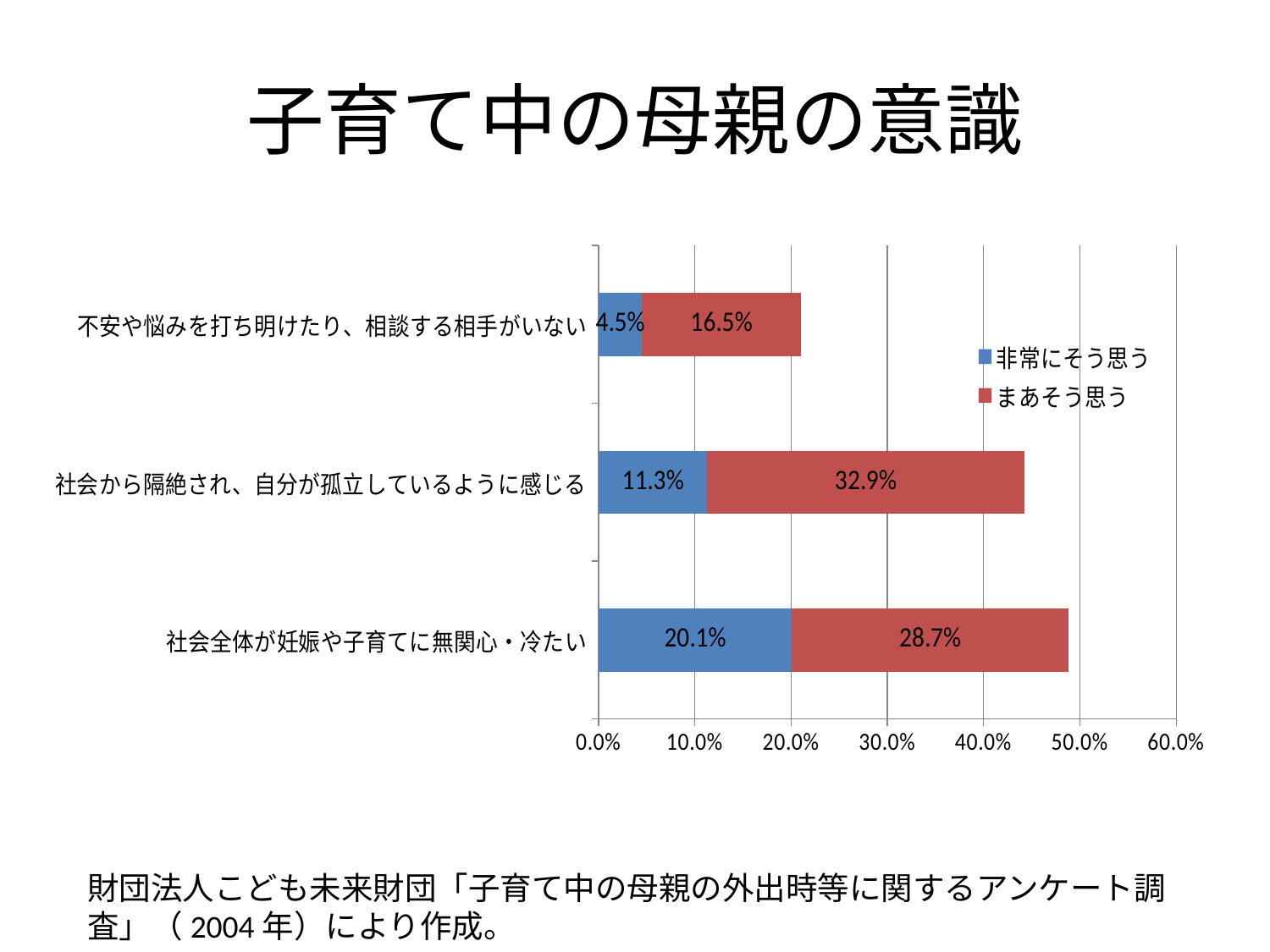
Which category has the highest value for まあそう思う? 社会から隔絶され、自分が孤立しているように感じる How many categories are shown in the chart? 3 Which category has the lowest value for 非常にそう思う? 不安や悩みを打ち明けたり、相談する相手がいない What kind of chart is shown on the slide? Stacked bar chart Which is larger: the 非常にそう思う value for 社会から隔絶され、自分が孤立しているように感じる or for 社会全体が妊娠や子育てに無関心・冷たい? 社会全体が妊娠や子育てに無関心・冷たい How many series does the legend list? 2 What is the total of the stacked bar for 不安や悩みを打ち明けたり、相談する相手がいない? 21.0% What is the value of 非常にそう思う for 不安や悩みを打ち明けたり、相談する相手がいない? 4.5% What is the difference between the まあそう思う values for 社会全体が妊娠や子育てに無関心・冷たい and 不安や悩みを打ち明けたり、相談する相手がいない? 12.2% What is the value of まあそう思う for 社会から隔絶され、自分が孤立しているように感じる? 32.9% What is the value of 非常にそう思う for 社会全体が妊娠や子育てに無関心・冷たい? 20.1% What is the total of the stacked bar for 社会全体が妊娠や子育てに無関心・冷たい? 48.8%